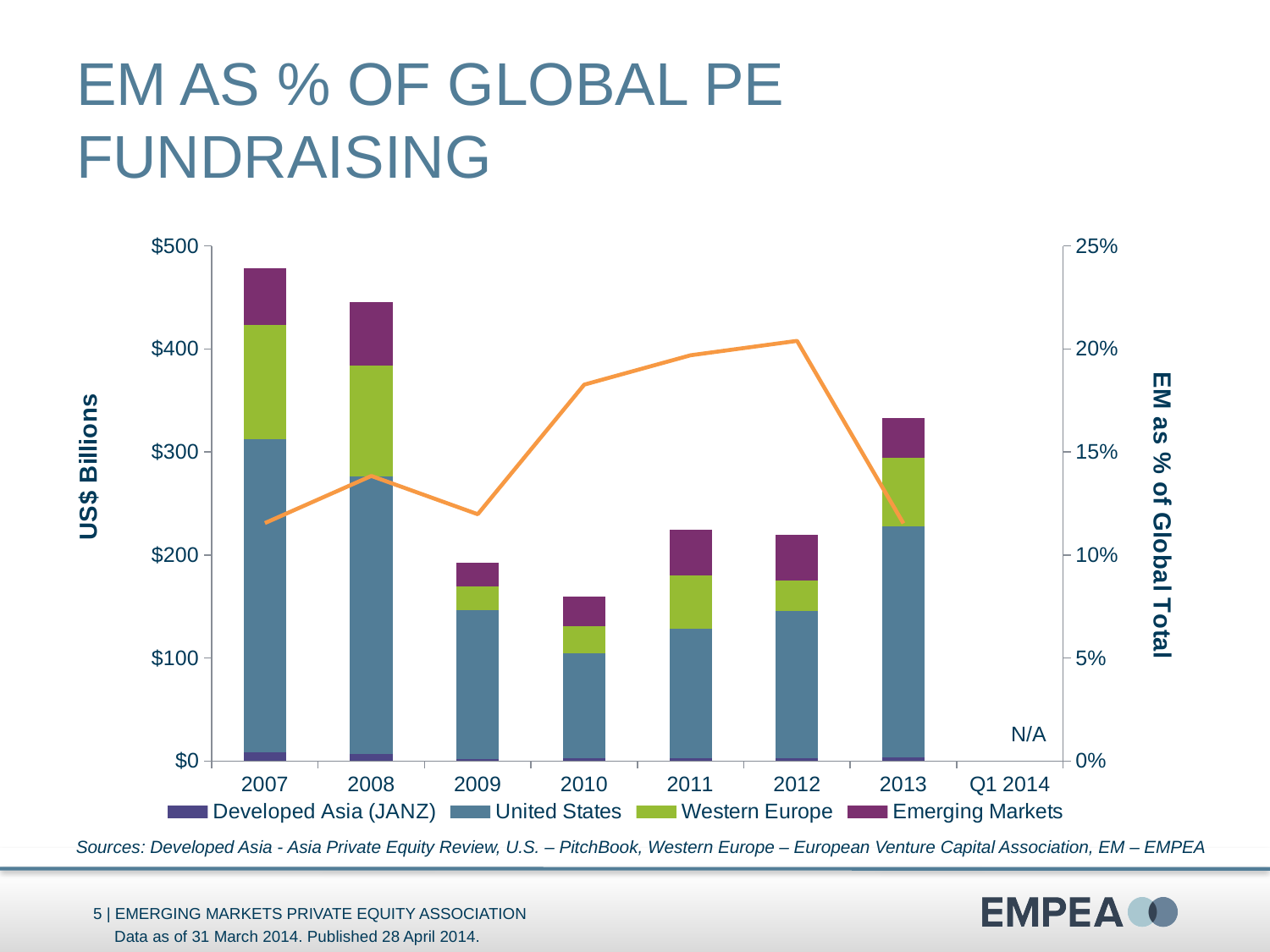
How many series does the legend list? 4 What is the label of the left vertical axis? US$ Billions Is the EM as % of Global Total line value for 2010 greater or less than 15%? greater What is shown for Q1 2014 on the chart? N/A How many categories are shown on the x axis? 8 Is the total stacked bar for 2010 greater or less than $200? less Among the years with bars, which year has the shortest stacked bar? 2010 Which is larger, the total stacked bar for 2008 or for 2013? 2008 Which year has the tallest stacked bar? 2007 Does the EM as % of Global Total line rise or fall from 2009 to 2012? Rise Is the total stacked bar for 2007 greater or less than $400? greater What kind of chart is shown on the slide? A stacked bar chart with a line